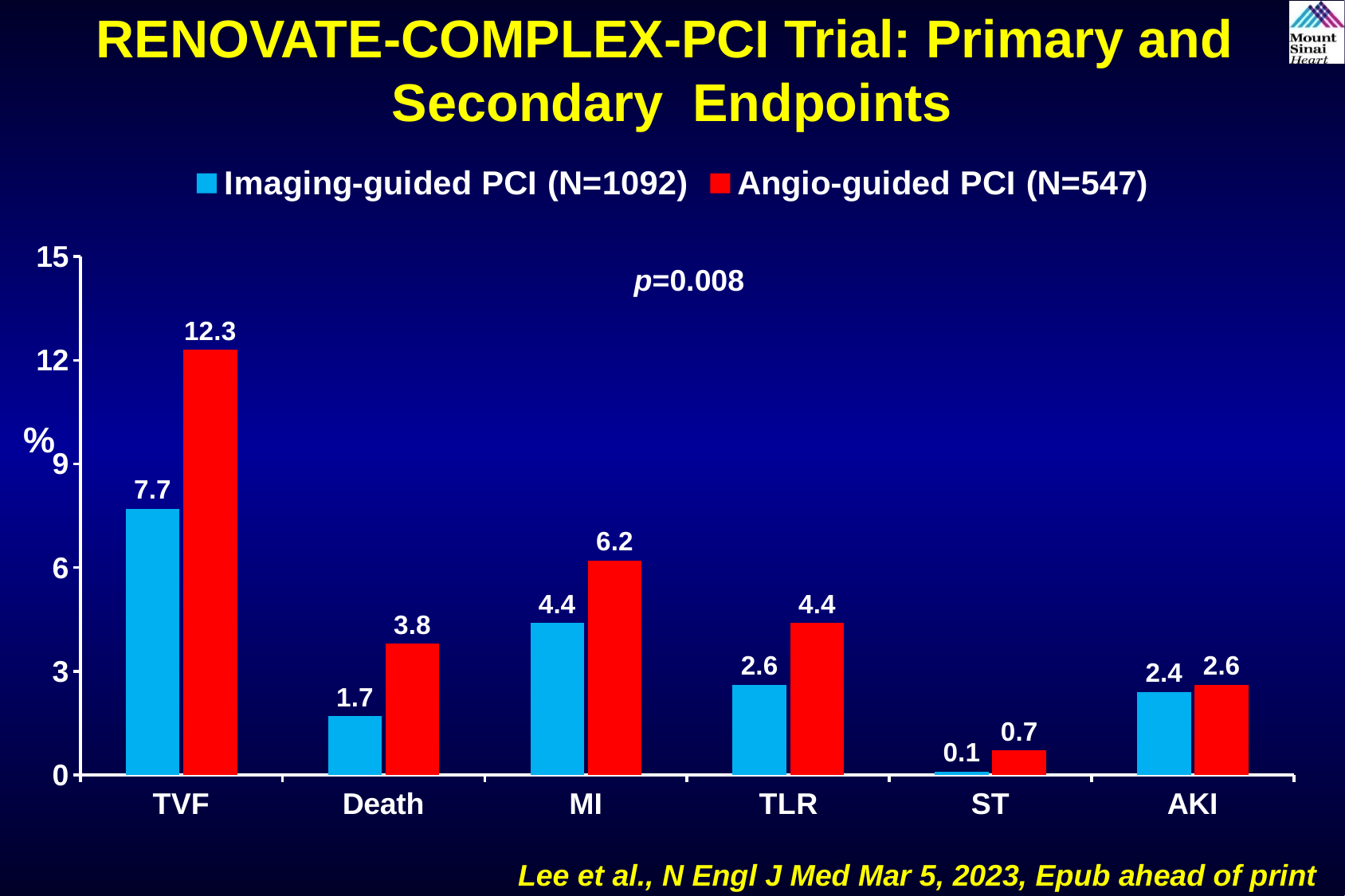
Which endpoint has the lowest value for Imaging-guided PCI? ST Which is larger for TLR: the Imaging-guided PCI value or the Angio-guided PCI value? Angio-guided PCI Which endpoint has the highest value for Angio-guided PCI? TVF What is the difference between the Angio-guided PCI and Imaging-guided PCI values for TVF? 4.6 What colour represents Angio-guided PCI (N=547) in the legend? Red What is the difference between the Angio-guided PCI and Imaging-guided PCI values for MI? 1.8 What is the value for Imaging-guided PCI for Death? 1.7 What is the value for Angio-guided PCI for TVF? 12.3 How many endpoint categories are shown on the x axis? 6 What kind of chart is shown on the slide? Bar chart How many series does the legend list? 2 What is the value for Imaging-guided PCI for ST? 0.1